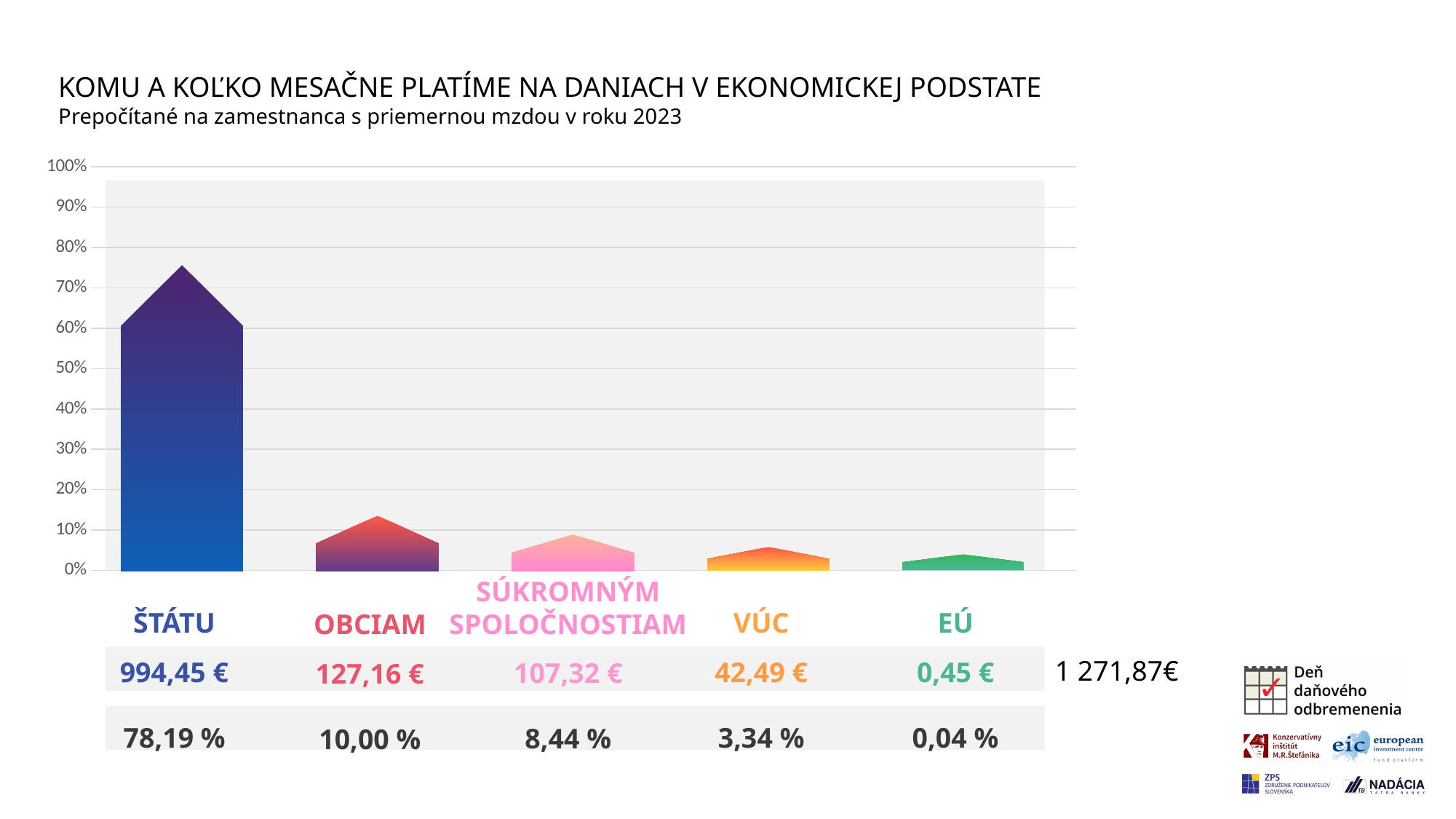
Which is larger, the amount paid to OBCIAM or to SÚKROMNÝM SPOLOČNOSTIAM? OBCIAM Which category receives the lowest monthly amount? EÚ What kind of chart is shown on the slide? bar chart What percentage share is shown for OBCIAM? 10,00 % Which category receives the highest monthly amount? ŠTÁTU What total monthly amount is shown to the right of the euro values? 1 271,87€ Is the bar for ŠTÁTU greater or less than 50% on the axis? greater How many categories are shown in the chart? 5 What is the monthly amount paid to ŠTÁTU? 994,45 € What is the difference in euros between the amounts paid to OBCIAM and VÚC? 84,67 € What percentage share is shown for VÚC? 3,34 % What is the monthly amount paid to SÚKROMNÝM SPOLOČNOSTIAM? 107,32 €